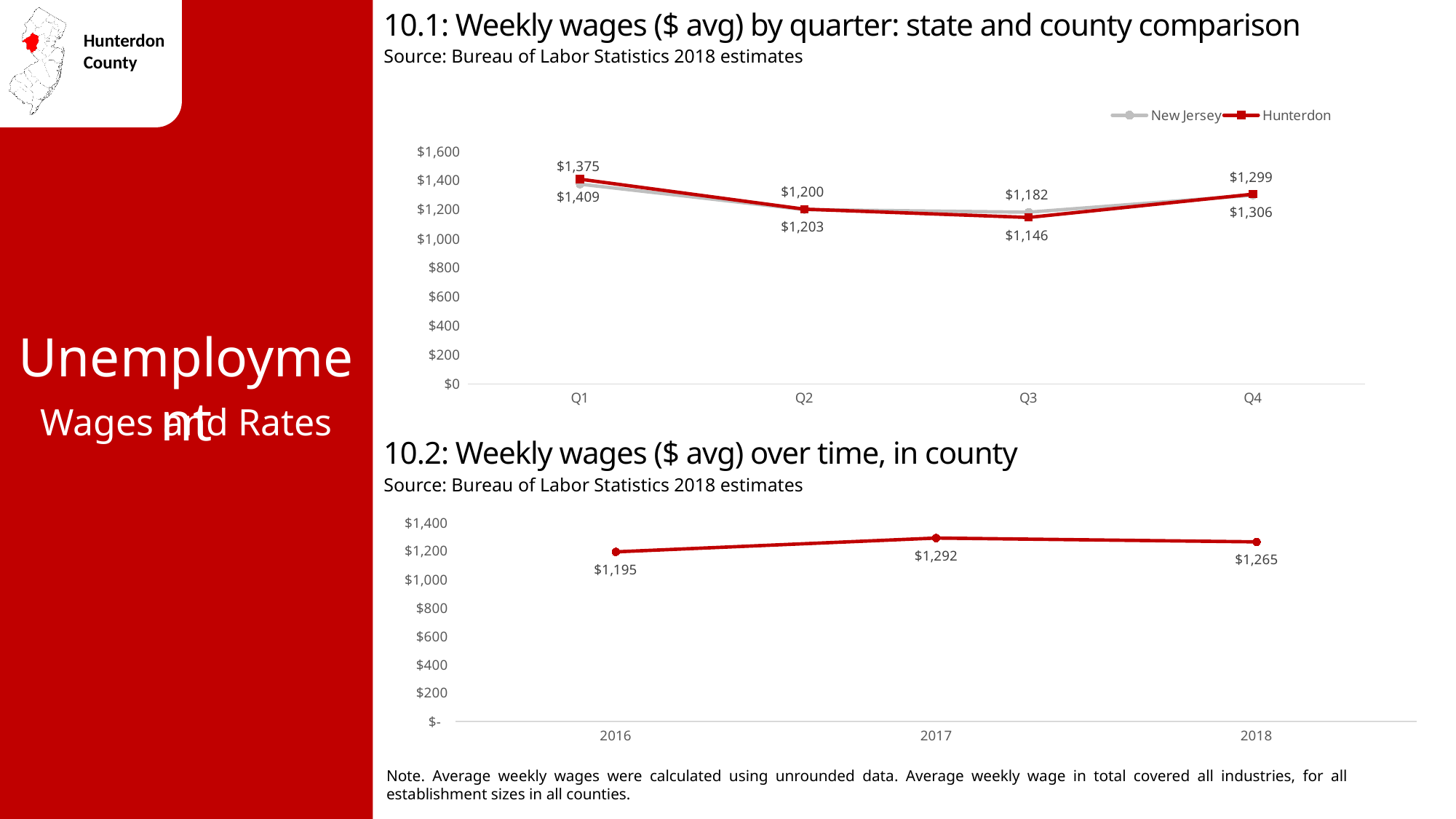
In chart 10.1, what is the New Jersey average weekly wage in Q1? $1,375 In chart 10.2, which year has the lowest average weekly wage? 2016 In chart 10.1, which series is drawn in red? Hunterdon In chart 10.1, in which quarter is the Hunterdon weekly wage lowest? Q3 In chart 10.1, how many series does the legend list? 2 In chart 10.2, what is the average weekly wage in 2017? $1,292 In chart 10.1, what is the Hunterdon average weekly wage in Q3? $1,146 In chart 10.2, what is the difference between the 2017 and 2016 weekly wages? $97 In chart 10.2, how many years are plotted? 3 What type of chart is chart 10.2? Line chart In chart 10.1, what is the difference between the New Jersey and Hunterdon weekly wages in Q3? $36 In chart 10.1, in which quarter is the New Jersey weekly wage highest? Q1